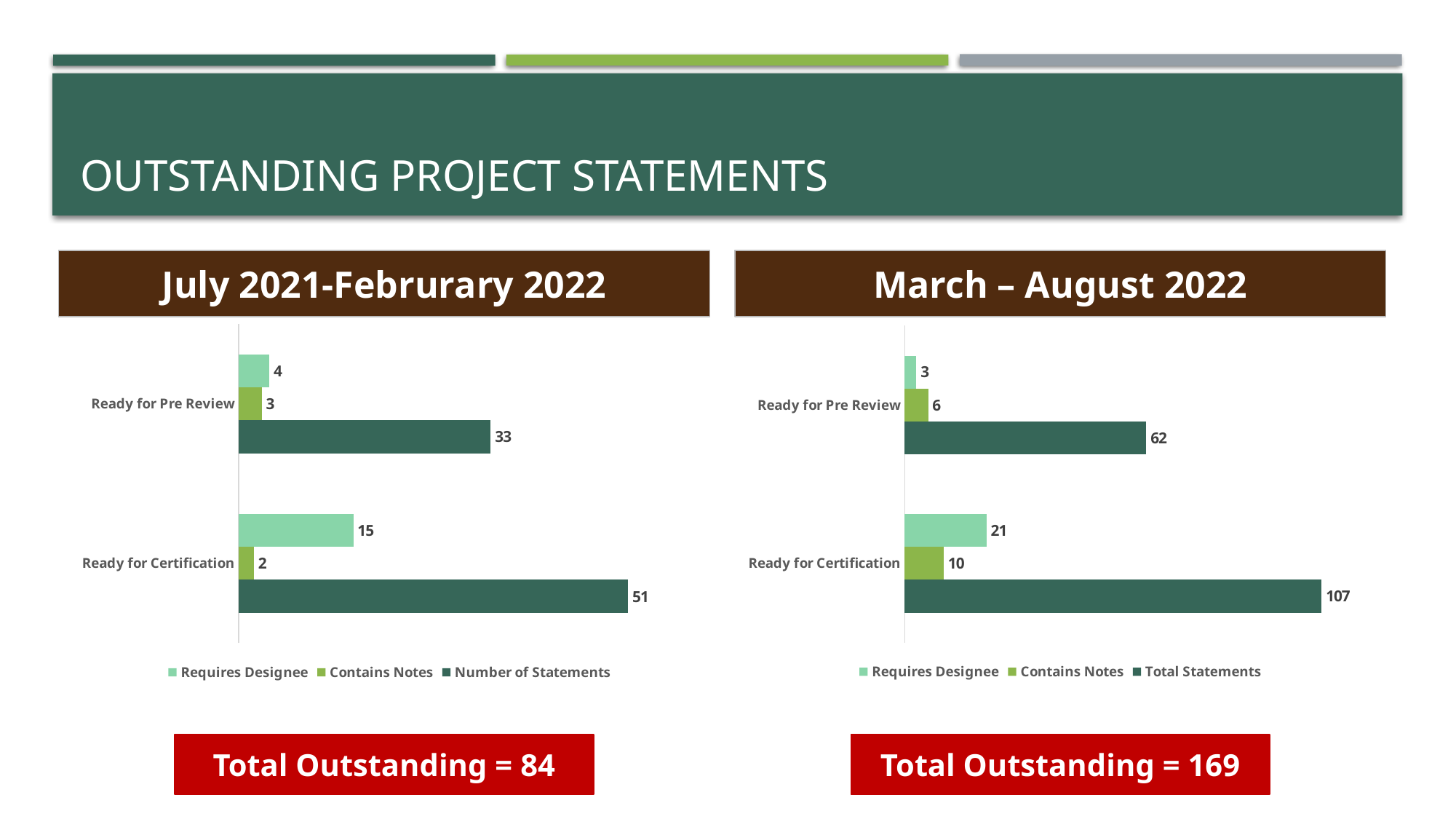
In the July 2021-February 2022 chart, what is the Number of Statements for Ready for Certification? 51 How many series does the legend of the March – August 2022 chart list? 3 In the March – August 2022 chart, which category has the lower Contains Notes value? Ready for Pre Review Is the Total Statements value for Ready for Certification larger in the March – August 2022 chart or the July 2021-February 2022 chart? March – August 2022 How many categories are shown in the July 2021-February 2022 chart? 2 In the March – August 2022 chart, what is the difference between Total Statements for Ready for Certification and Ready for Pre Review? 45 In the July 2021-February 2022 chart, which category has the higher Number of Statements? Ready for Certification In the March – August 2022 chart, what is the Total Statements value for Ready for Pre Review? 62 In the March – August 2022 chart, what is the Requires Designee value for Ready for Certification? 21 In the July 2021-February 2022 chart, what is the difference between Requires Designee for Ready for Certification and Ready for Pre Review? 11 What type of chart is used for the July 2021-February 2022 data? Bar chart In the July 2021-February 2022 chart, what is the Contains Notes value for Ready for Pre Review? 3